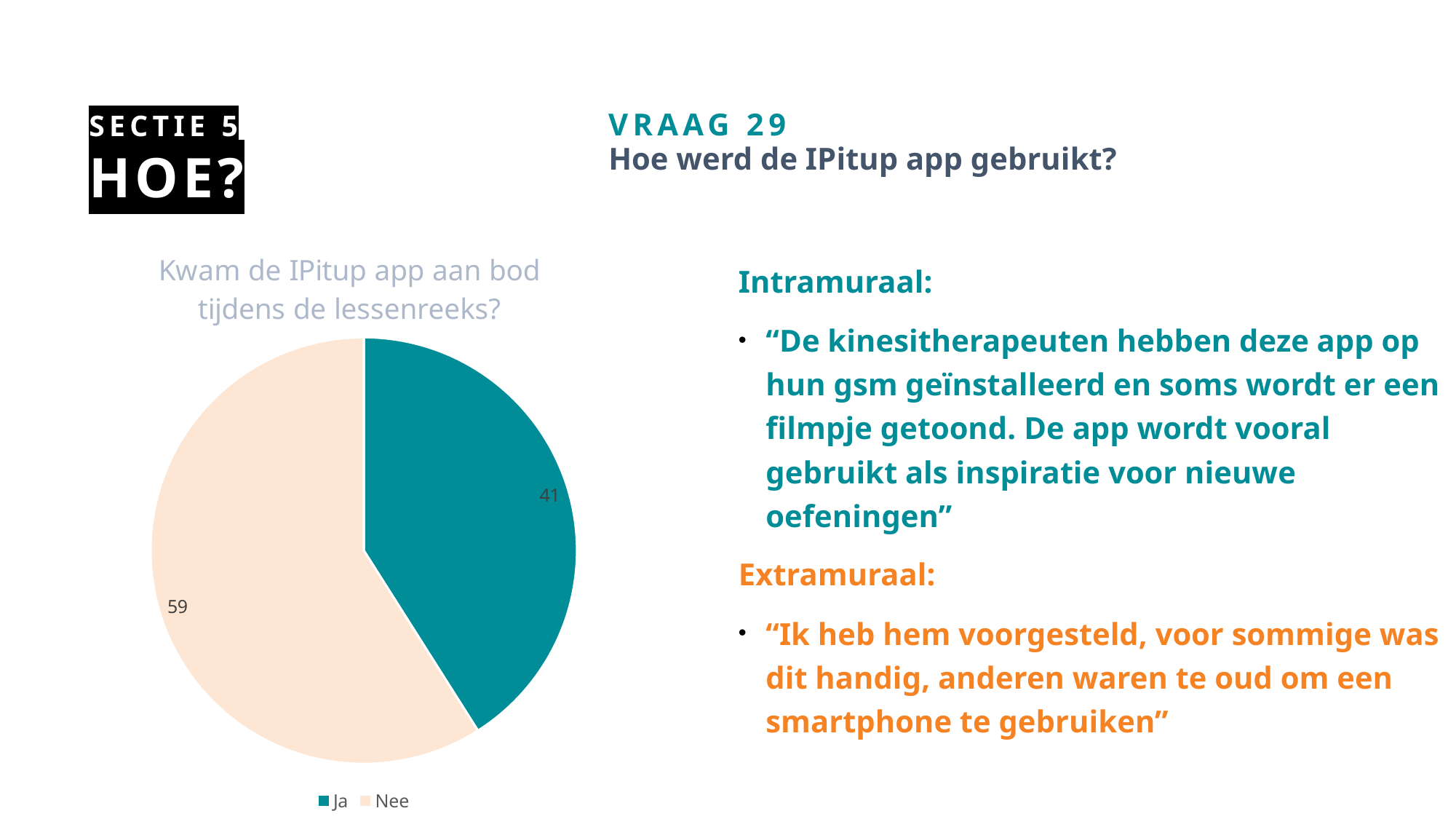
What is the total of the values shown in the pie chart? 100 How many entries does the legend of the pie chart list? 2 How many slices does the pie chart have? 2 What is the value for "Nee" in the pie chart? 59 What is the value for "Ja" in the pie chart? 41 Which slice of the pie chart is the largest? Nee What share of the pie chart does the "Ja" slice represent? 41% What is the title of the pie chart? Kwam de IPitup app aan bod tijdens de lessenreeks? Which is larger in the pie chart, "Ja" or "Nee"? Nee Which slice of the pie chart is the smallest? Ja What kind of chart is shown on the slide? pie chart What is the difference between the values for "Nee" and "Ja" in the pie chart? 18